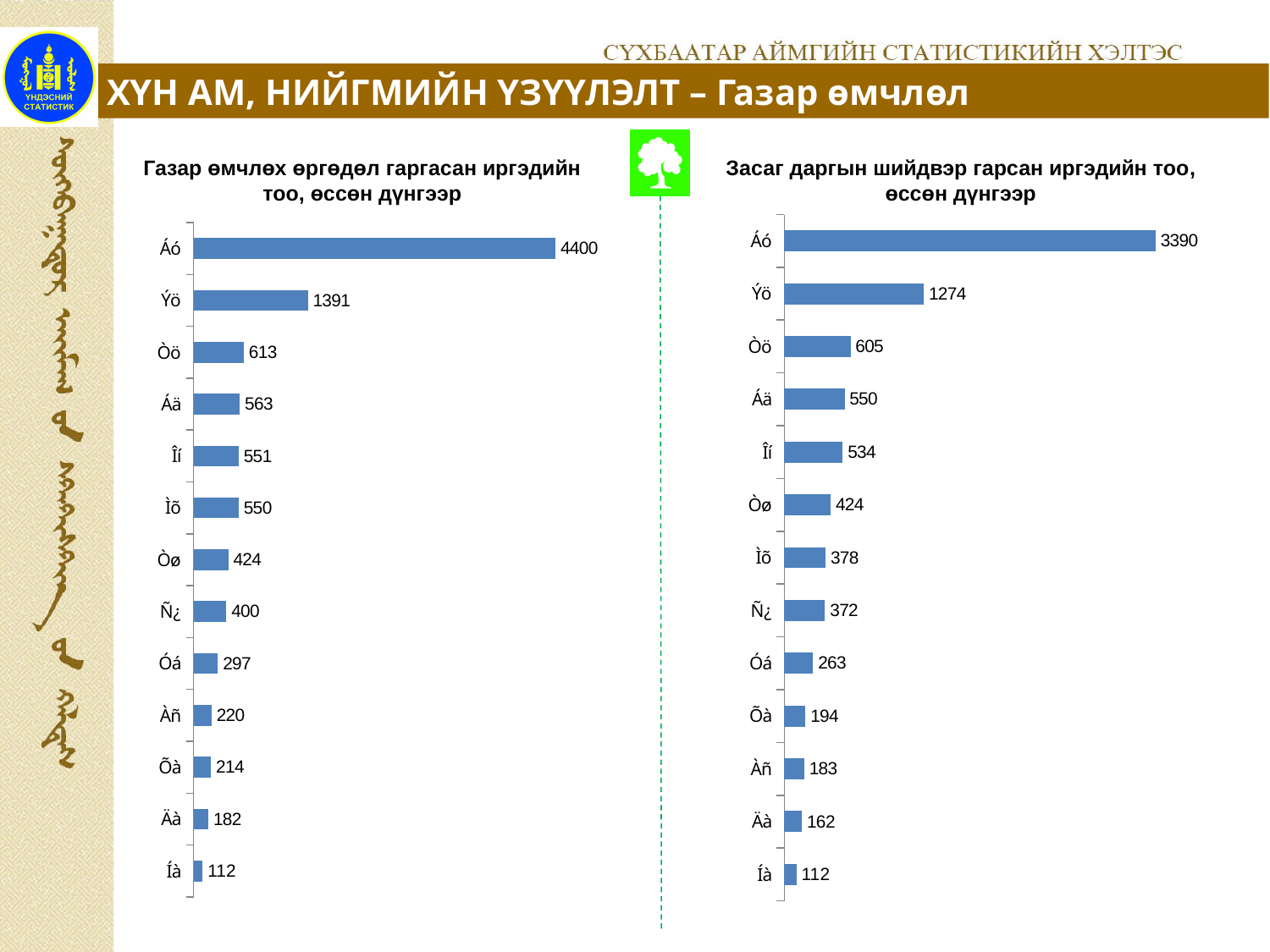
In the left chart, which is larger, the value for Òö or the value for Óá? Òö What is the title of the left chart? Газар өмчлөх өргөдөл гаргасан иргэдийн тоо, өссөн дүнгээр In the left chart, what is the value for Ýö? 1391 In the right chart, what is the value for Òö? 605 In the right chart, which category has the lowest value? Íà How many categories are shown in the right chart? 13 In the left chart, what is the difference between the values for Áó and Ýö? 3009 In the right chart, which is larger, the value for Ýö or the value for Áä? Ýö In the right chart, what is the difference between the values for Òø and Ìõ? 46 How many categories are shown in the left chart? 13 In the left chart, which category has the highest value? Áó What kind of chart is the right chart? bar chart